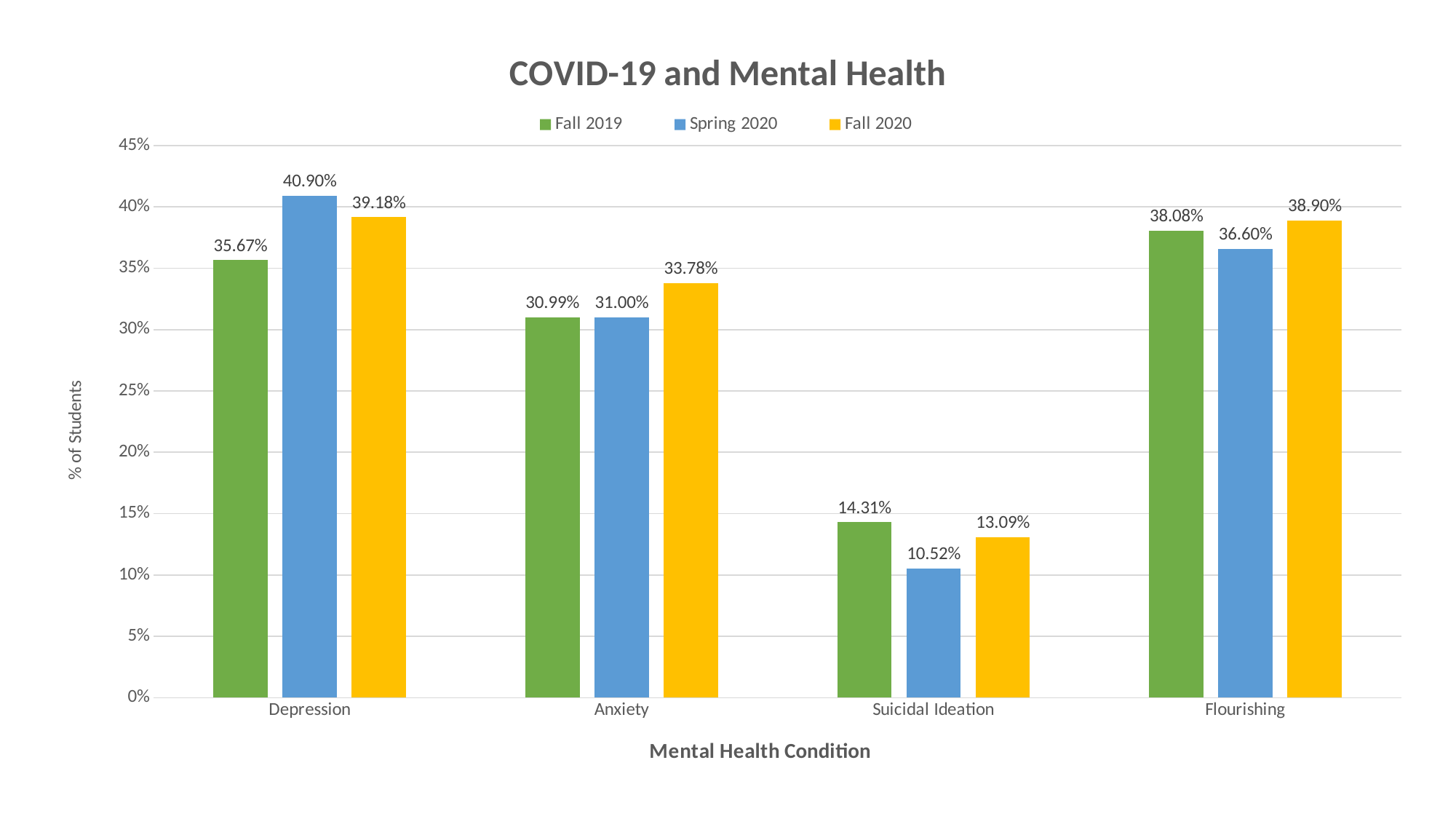
What is the Spring 2020 value for Depression? 40.90% Which is larger for Depression: the Fall 2019 value or the Fall 2020 value? Fall 2020 How many mental health conditions are shown on the x axis? 4 What is the Fall 2020 value for Anxiety? 33.78% Which mental health condition has the lowest Fall 2020 value? Suicidal Ideation What is the Fall 2019 value for Suicidal Ideation? 14.31% What is the difference between the Fall 2020 and Fall 2019 values for Flourishing? 0.82% How many series does the legend list? 3 What is the Spring 2020 value for Flourishing? 36.60% What kind of chart is shown on the slide? Bar chart Which mental health condition has the highest Spring 2020 value? Depression What is the difference between the Fall 2019 and Spring 2020 values for Suicidal Ideation? 3.79%